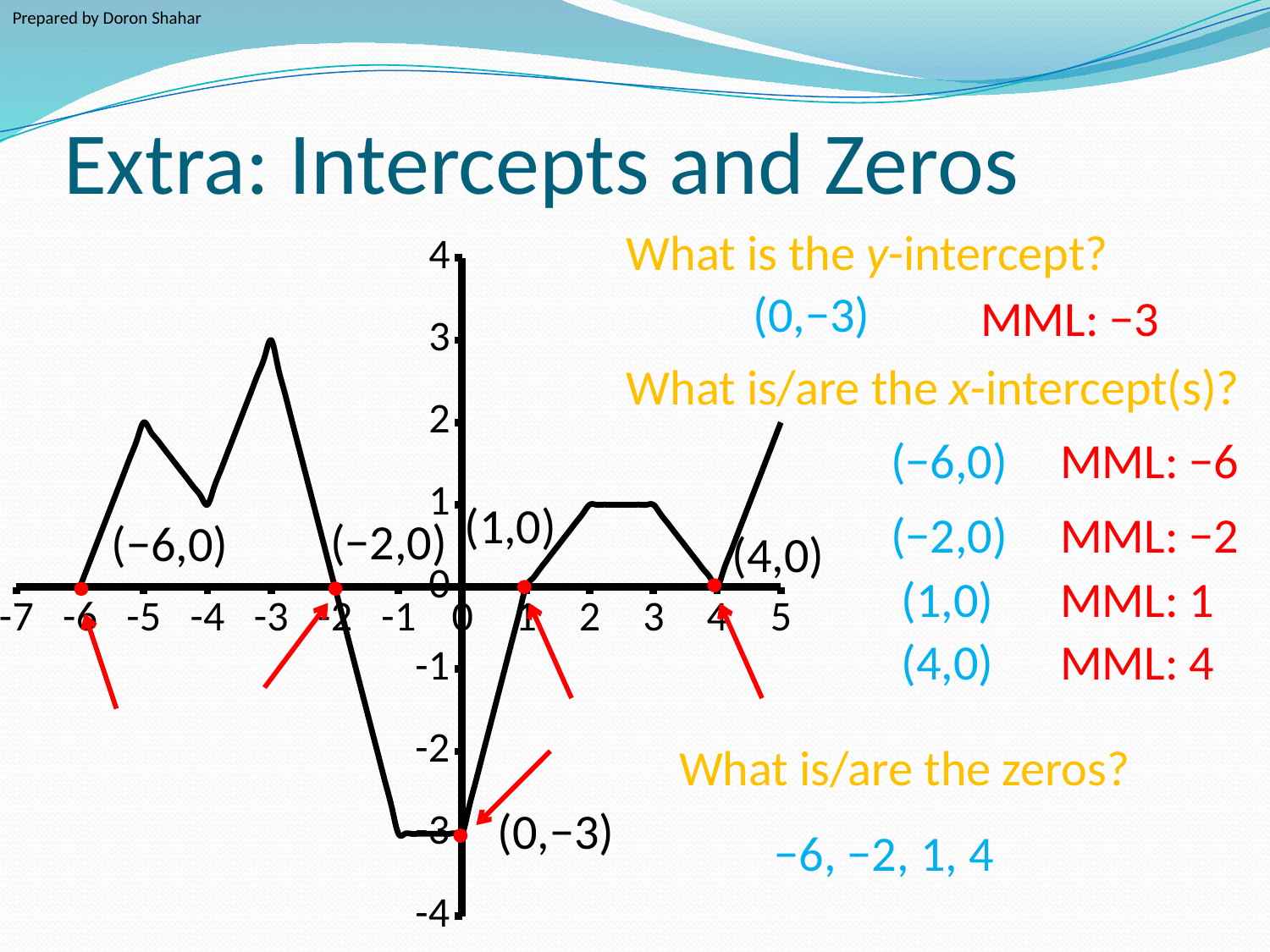
Is the value of the graph at x = -3 greater or less than 2? greater Does the graph rise or fall as x goes from -3 to -1? fall What are the zeros of the function, as listed on the slide? −6, −2, 1, 4 What is the leftmost x-intercept labeled on the graph? (−6,0) At which x value does the graph reach its highest point? -3 What is the y-intercept of the graph, as labeled on the slide? (0,−3) Is the value of the graph at x = -1 greater or less than -2? less What is the rightmost x-intercept labeled on the graph? (4,0) How many x-intercepts are marked on the graph? 4 What kind of chart is shown on the slide? line chart Which is larger, the value of the graph at x = -3 or at x = -5? x = -3 How many points are marked with red dots on the graph? 5